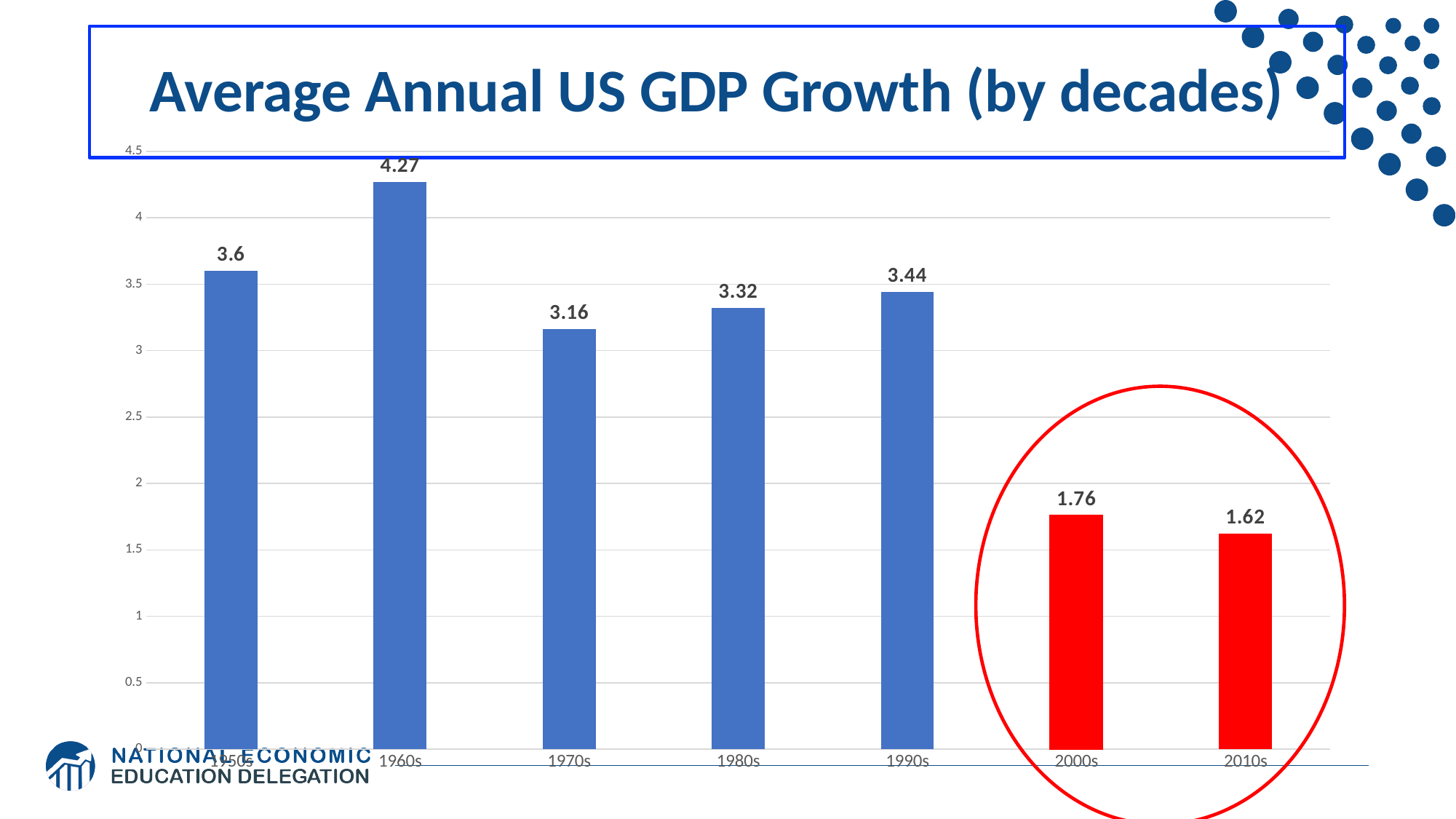
How many decades are plotted in the chart? 7 Is the value for the 2000s greater or less than 2? less Which decade has the highest average annual GDP growth? 1960s What kind of chart is shown on the slide? bar chart What value is shown for the 1980s? 3.32 Which bars are coloured red and circled? 2000s and 2010s What is the average annual US GDP growth shown for the 1960s? 4.27 Which decade has the lowest average annual GDP growth? 2010s What value is shown for the 2010s? 1.62 Which is larger, the value for the 1970s or the value for the 1990s? 1990s What is the title of the chart? Average Annual US GDP Growth (by decades) What is the difference between the values for the 1960s and the 2000s? 2.51